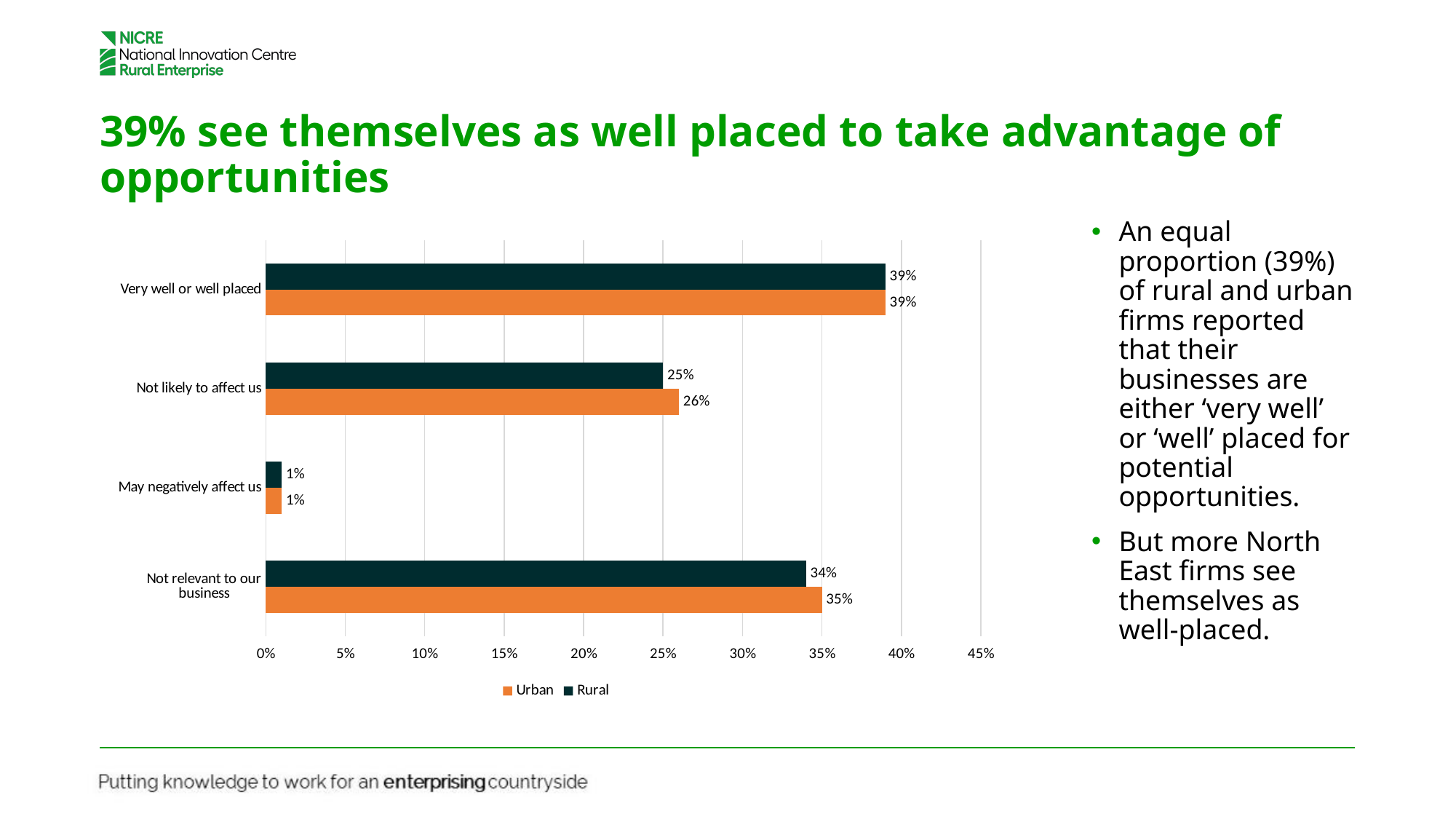
What is the Urban value for 'Not likely to affect us'? 26% For 'Not likely to affect us', which is larger, the Urban or the Rural value? Urban How many categories are shown on the chart? 4 What is the Rural value for 'Very well or well placed'? 39% Which colour represents the Rural series in the chart? Dark green What is the Urban value for 'May negatively affect us'? 1% Which category has the lowest Rural value? May negatively affect us What kind of chart is shown on the slide? Bar chart What is the difference between the Urban and Rural values for 'Not relevant to our business'? 1% What is the Rural value for 'Not relevant to our business'? 34% Which category has the highest Urban value? Very well or well placed How many series does the legend list? 2